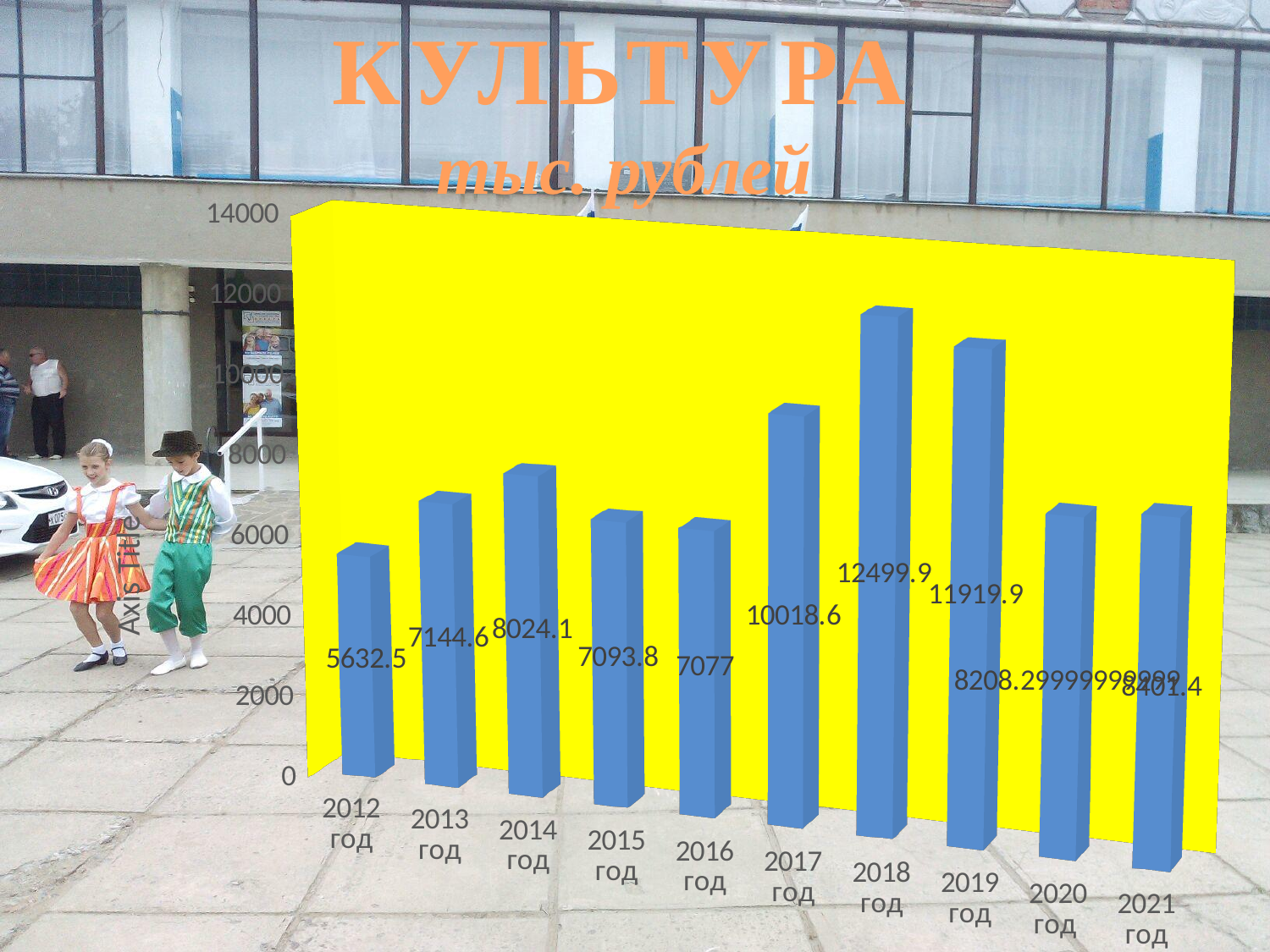
Which year has the highest value? 2018 год What is the difference between the values for 2018 год and 2019 год? 580 What is the value for 2012 год? 5632.5 What is the value for 2018 год? 12499.9 Which year has the lowest value? 2012 год Is the value for 2017 год greater or less than 8000? greater What is the value for 2016 год? 7077 What is the difference between the values for 2013 год and 2012 год? 1512.1 What kind of chart is shown on the slide? bar chart Which is larger, the value for 2014 год or 2015 год? 2014 год How many years are shown on the x axis? 10 What is the value for 2017 год? 10018.6